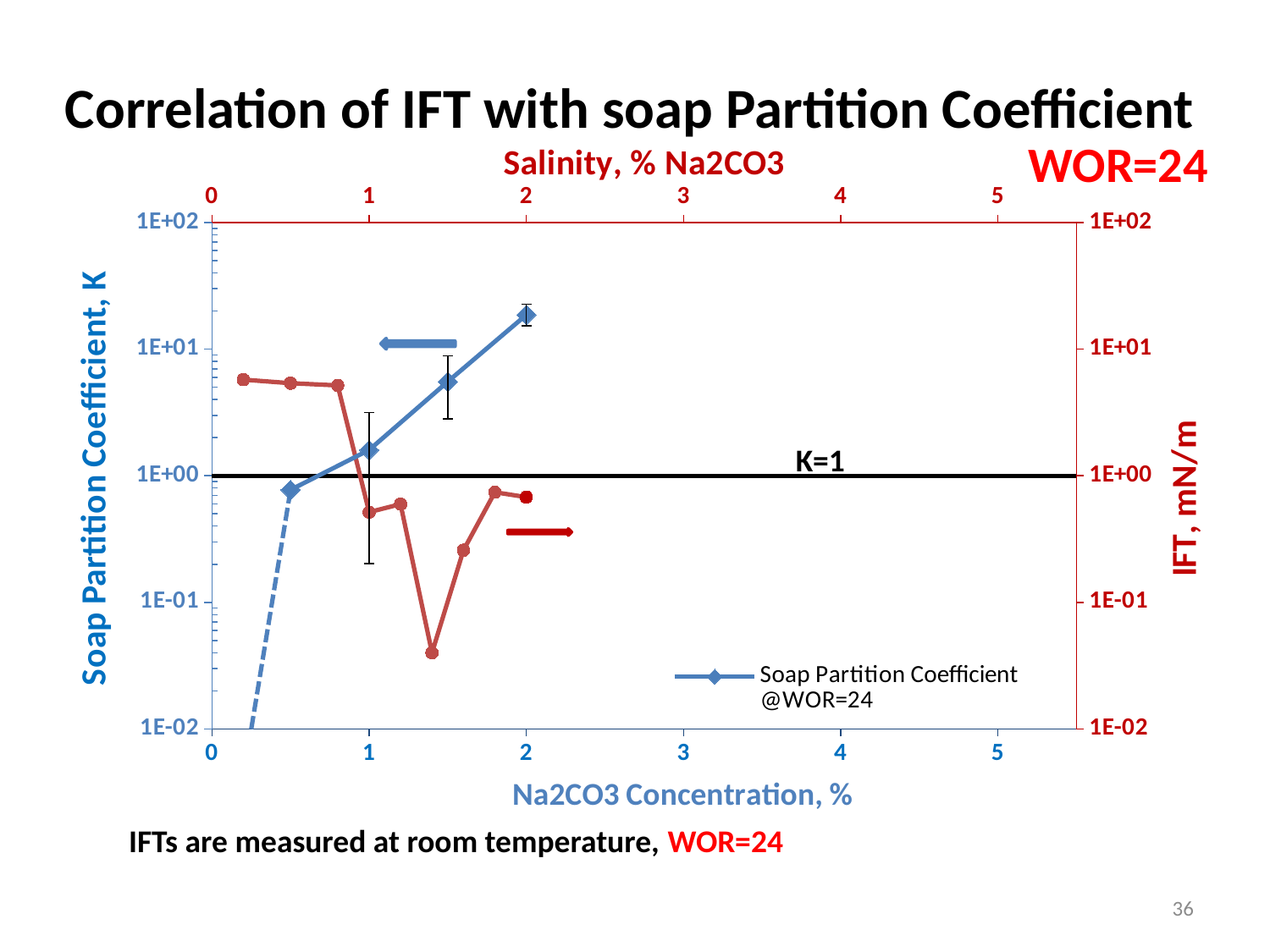
How many data points are plotted on the red IFT curve? 9 Is the Soap Partition Coefficient at 2% Na2CO3 greater or less than 1E+01? greater What kind of chart is shown on the slide? line chart What is the title of the chart on the slide? Correlation of IFT with soap Partition Coefficient How many data points are plotted for the Soap Partition Coefficient series (blue diamonds)? 4 At which Na2CO3 concentration is the Soap Partition Coefficient highest? 2 What is the label of the right-hand vertical axis? IFT, mN/m Is the Soap Partition Coefficient at 0.5% Na2CO3 greater or less than 1E+00? less How many entries does the chart legend list? 1 Does the Soap Partition Coefficient rise or fall as Na2CO3 concentration increases? rise